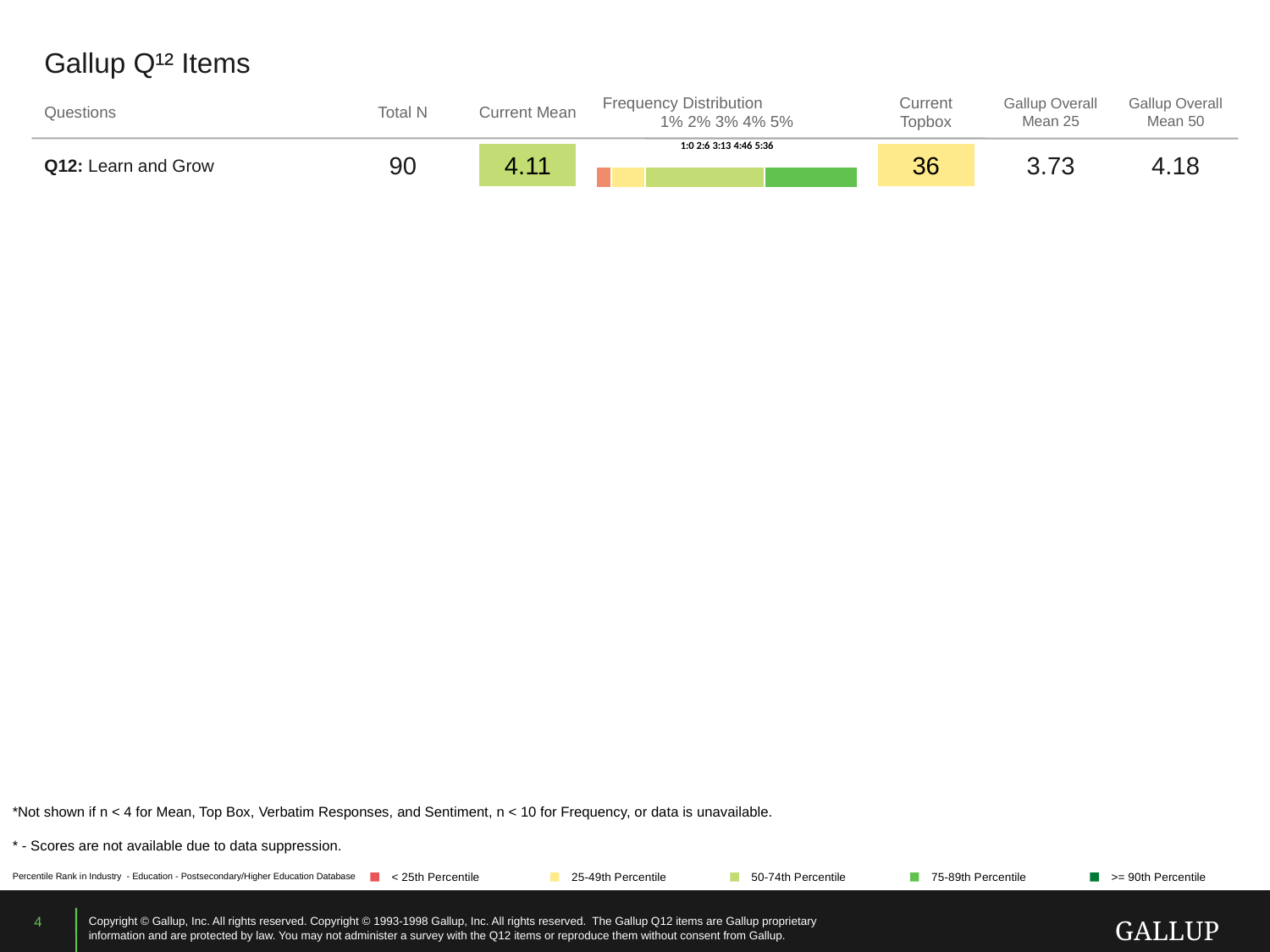
What colour is the segment for 5 responses in the Frequency Distribution bar for Q12: Learn and Grow? green Which response value has the largest share in the Frequency Distribution bar for Q12: Learn and Grow? 4 In the Frequency Distribution bar for Q12: Learn and Grow, what percentage of responses are a 3? 13 In the Frequency Distribution bar for Q12: Learn and Grow, what percentage of responses are a 5? 36 Which response value has the smallest share in the Frequency Distribution bar for Q12: Learn and Grow? 1 In the Frequency Distribution bar for Q12: Learn and Grow, what percentage of responses are a 1? 0 How many response categories (1 through 5) are labelled in the Frequency Distribution for Q12: Learn and Grow? 5 In the Frequency Distribution bar for Q12: Learn and Grow, which is larger: the share of 3 responses or the share of 2 responses? 3 responses In the Frequency Distribution bar for Q12: Learn and Grow, what percentage of responses are a 2? 6 In the Frequency Distribution bar for Q12: Learn and Grow, what percentage of responses are a 4? 46 In the Frequency Distribution bar for Q12: Learn and Grow, how much larger is the share of 4 responses than the share of 5 responses? 10 What type of chart is used for the Frequency Distribution of Q12: Learn and Grow? bar chart